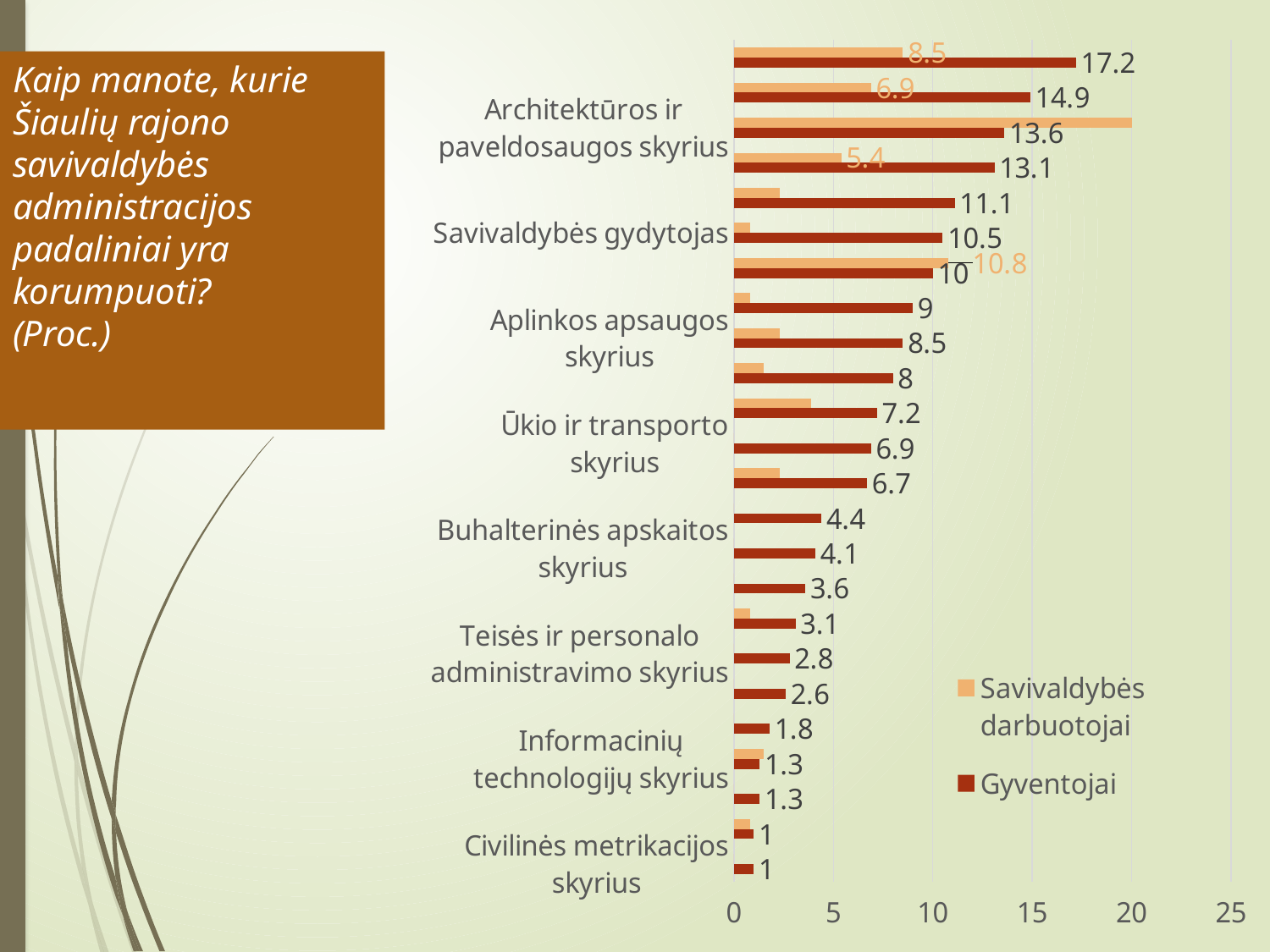
Do the Gyventojai values rise or fall going from the top of the chart to the bottom? fall Is the longest Savivaldybės darbuotojai bar greater or less than 15? greater How many series does the legend list? 2 What is the difference between the two highest Gyventojai values, 17.2 and 14.9? 2.3 For Civilinės metrikacijos skyrius, which series has the larger value, Gyventojai or Savivaldybės darbuotojai? Gyventojai What is the highest Gyventojai value shown in the chart? 17.2 What are the two series named in the legend? Savivaldybės darbuotojai and Gyventojai What is the maximum value shown on the horizontal axis? 25 What is the Gyventojai value for Informacinių technologijų skyrius? 1.3 What is the lowest Gyventojai value shown in the chart? 1 What is the Gyventojai value for Civilinės metrikacijos skyrius? 1 What kind of chart is shown on the slide? bar chart